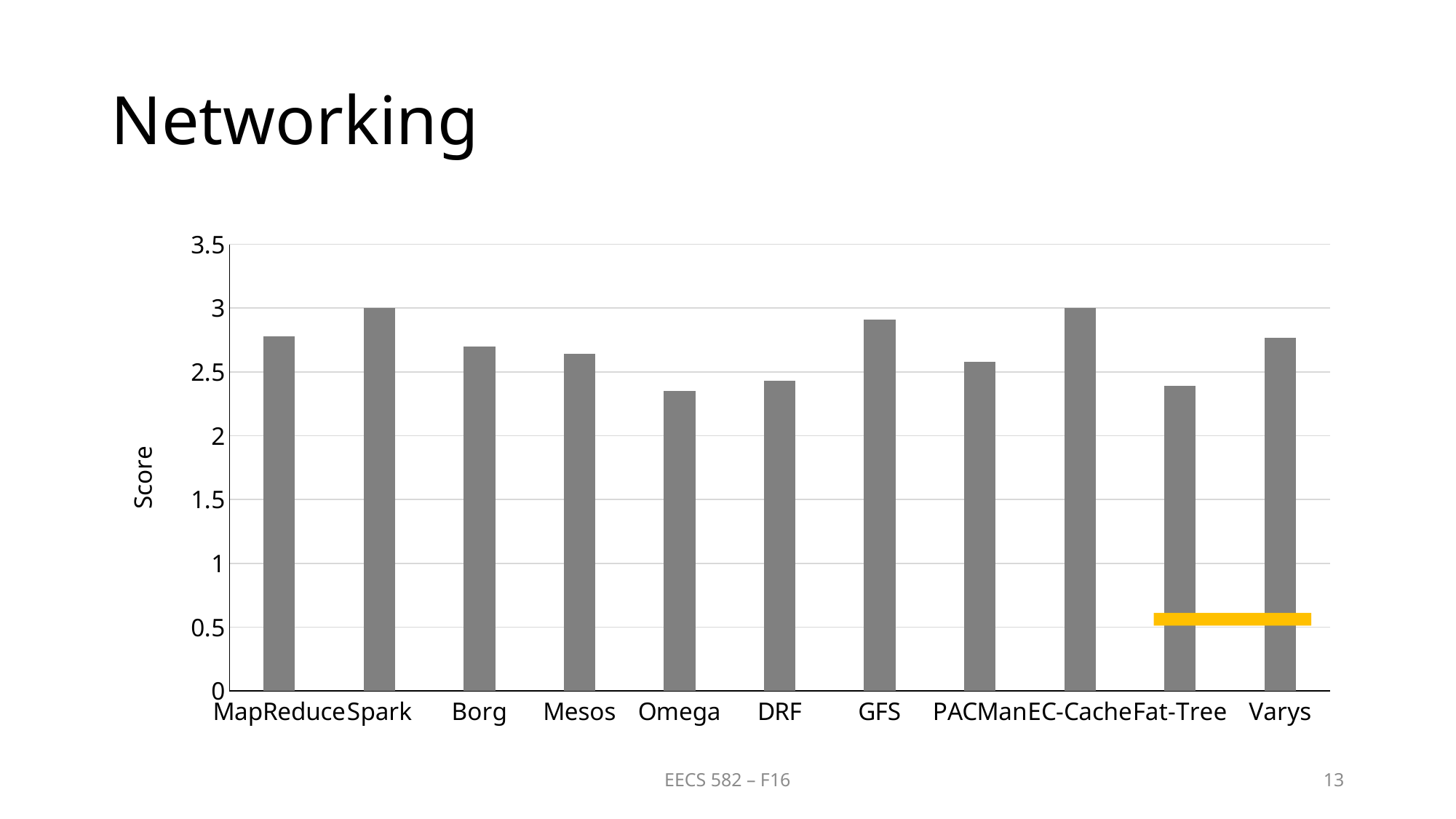
How many categories are plotted on the x axis? 11 Which has the higher score, GFS or DRF? GFS What is the title of the slide containing the chart? Networking What is the score for Spark? 3 Which has the higher score, Spark or Omega? Spark Is the value for Fat-Tree greater or less than 2.5? less What is the label of the y axis? Score Is the value for Omega greater or less than 2.5? less Is the value for MapReduce greater or less than 2.5? greater What is the score for EC-Cache? 3 What kind of chart is shown on the slide? bar chart